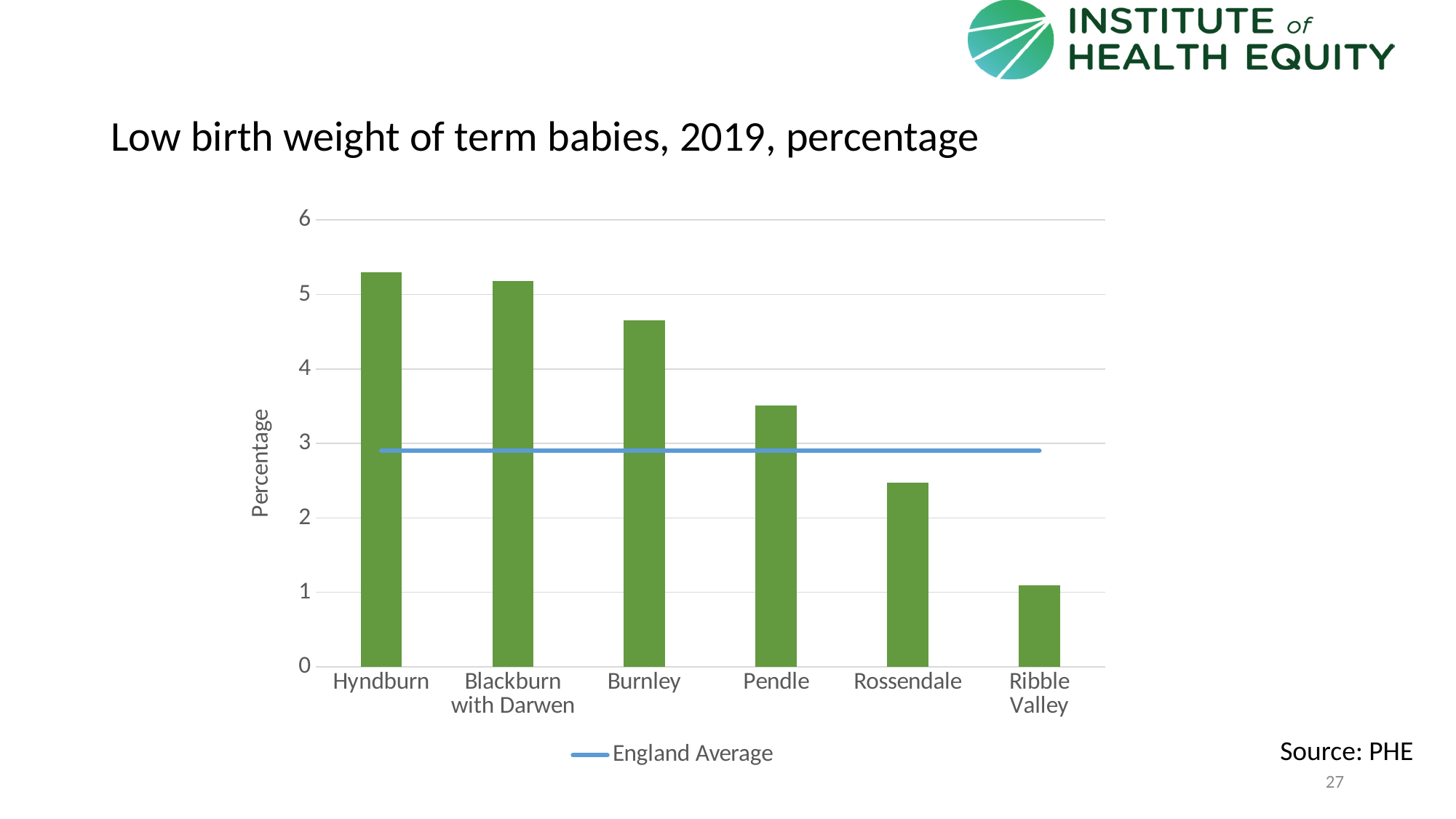
Is the value for Hyndburn greater or less than 5? greater What kind of chart is shown on the slide? Combination bar and line chart Which local authority has the lowest low birth weight percentage in the chart? Ribble Valley Do the bar values rise or fall moving from left to right along the x axis? Fall Is the value for Rossendale greater or less than 3? less Is the value for Burnley greater or less than 4? greater How many local authorities are shown on the x axis of the chart? 6 What series does the horizontal line in the chart represent, according to the legend? England Average How many series does the chart's legend list? 1 Which has the larger value, Burnley or Pendle? Burnley Which has the larger value, Rossendale or Ribble Valley? Rossendale